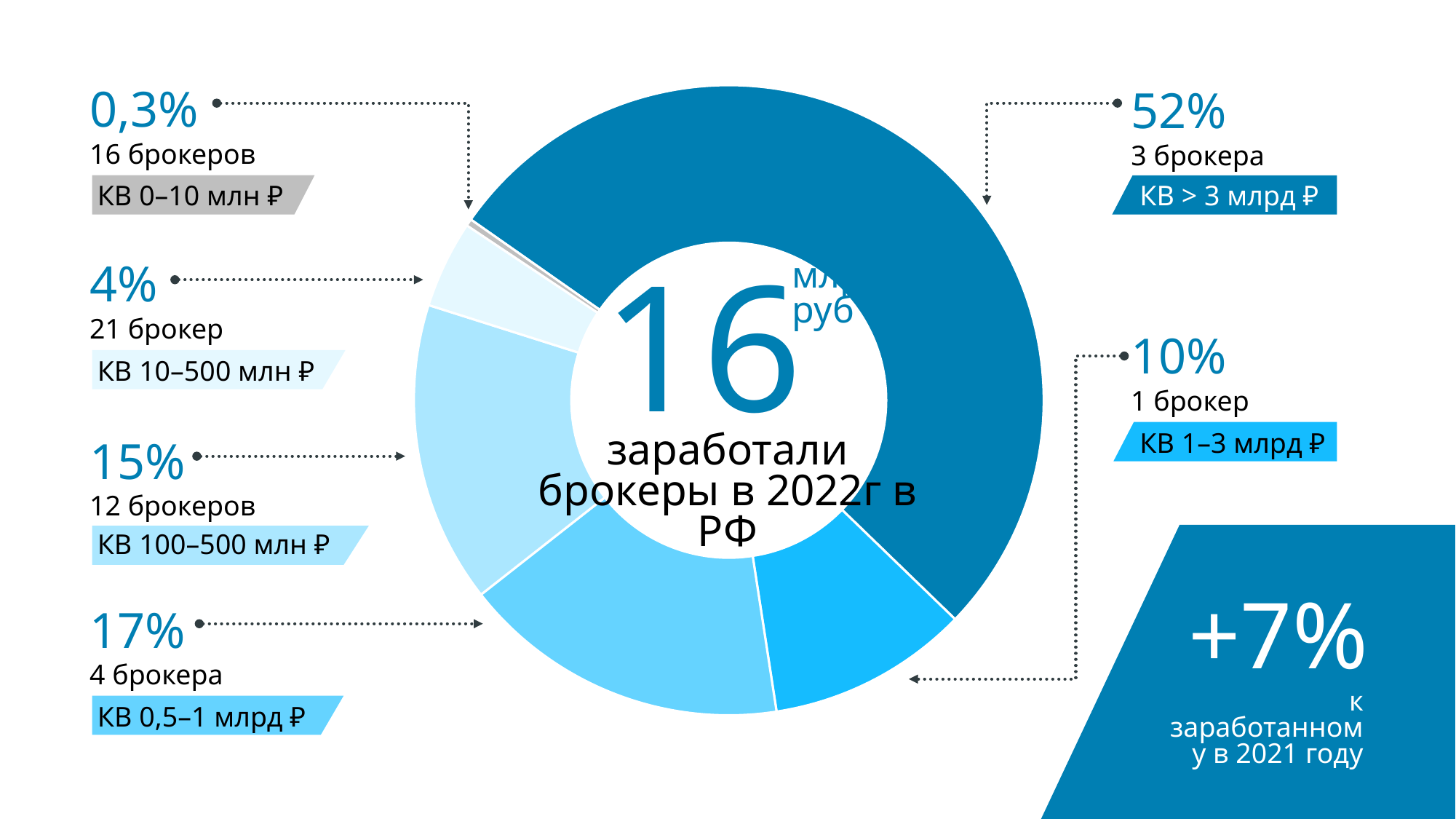
What share of the donut chart corresponds to brokers with КВ > 3 млрд ₽? 52% What is the difference in share between the КВ 0,5–1 млрд ₽ group and the КВ 100–500 млн ₽ group? 2% What share of the donut chart corresponds to brokers with КВ 0–10 млн ₽? 0,3% What type of chart is shown on the slide? Donut (pie) chart What total amount is shown in the centre of the donut chart? 16 млрд руб What share of the donut chart corresponds to brokers with КВ 0,5–1 млрд ₽? 17% How many segments does the donut chart have? 6 What share of the donut chart corresponds to brokers with КВ 1–3 млрд ₽? 10% Which group has the largest share of the donut chart? КВ > 3 млрд ₽ Which group has the smallest share of the donut chart? КВ 0–10 млн ₽ Which group has a larger share: КВ 1–3 млрд ₽ or КВ 100–500 млн ₽? КВ 100–500 млн ₽ How many brokers are in the КВ 10–500 млн ₽ group shown on the chart? 21 брокер